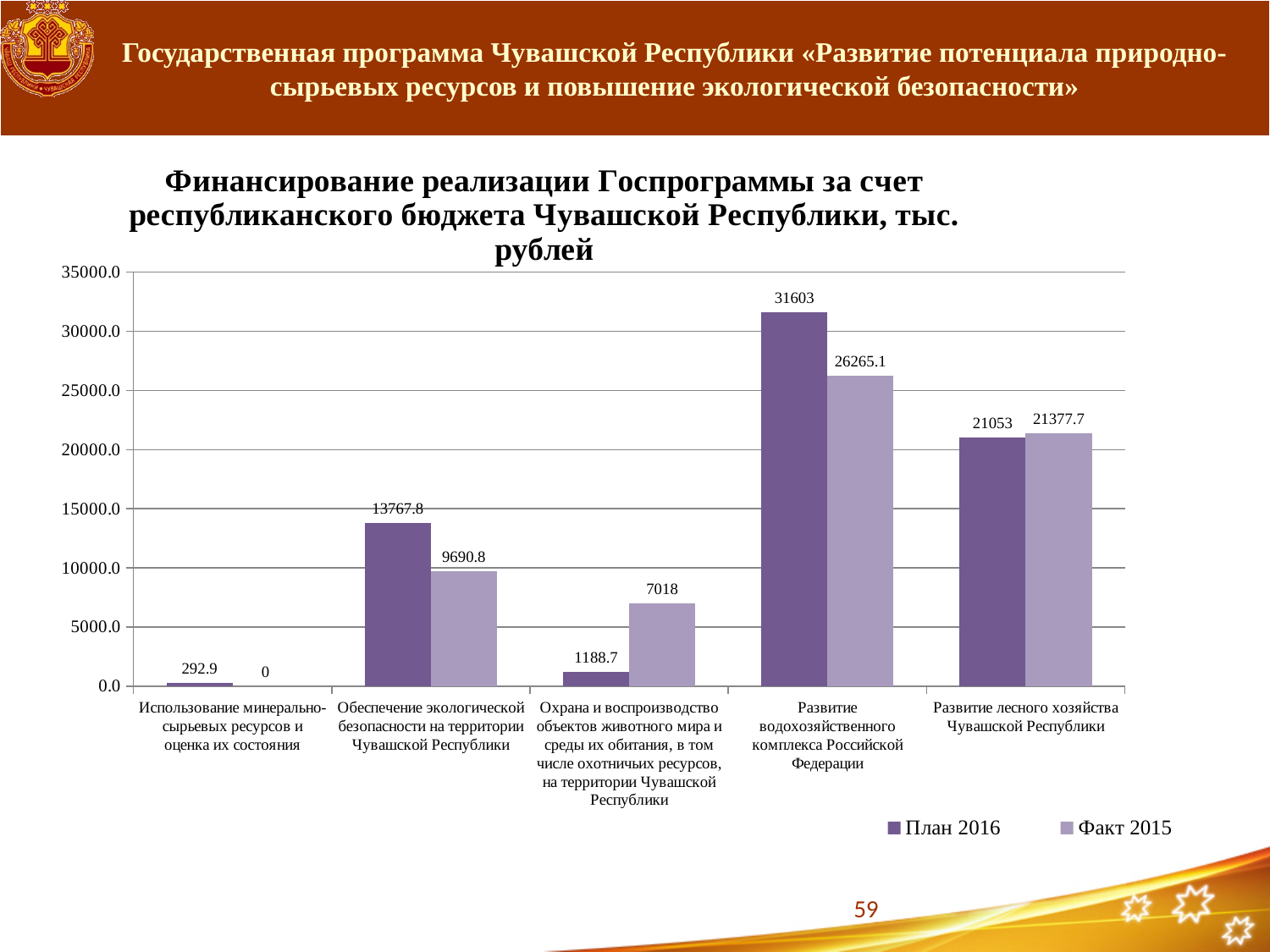
What type of chart is shown on the slide? bar chart What are the two series named in the legend? План 2016 and Факт 2015 Which category has the highest План 2016 value? Развитие водохозяйственного комплекса Российской Федерации What is the Факт 2015 value for «Обеспечение экологической безопасности на территории Чувашской Республики»? 9690.8 Is the План 2016 value for «Развитие лесного хозяйства Чувашской Республики» greater or less than 20000.0? greater What is the difference between the План 2016 and Факт 2015 values for «Развитие водохозяйственного комплекса Российской Федерации»? 5337.9 What is the План 2016 value for «Развитие водохозяйственного комплекса Российской Федерации»? 31603 How many series does the legend list? 2 For «Охрана и воспроизводство объектов животного мира и среды их обитания», which is larger: План 2016 or Факт 2015? Факт 2015 What is the Факт 2015 value for «Использование минерально-сырьевых ресурсов и оценка их состояния»? 0 Which category has the lowest Факт 2015 value? Использование минерально-сырьевых ресурсов и оценка их состояния How many categories are shown on the x axis of the chart? 5